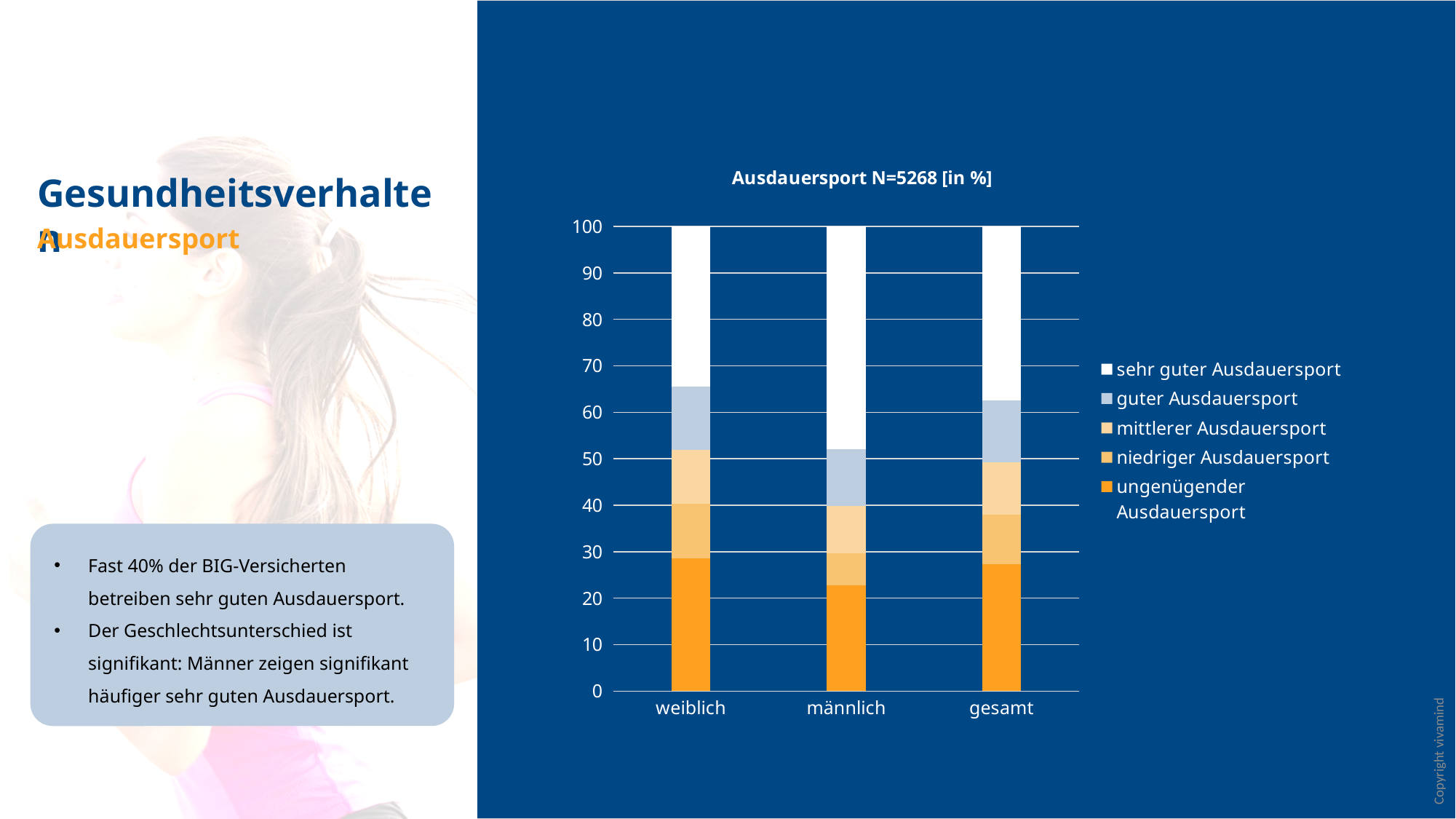
What is the title of the chart? Ausdauersport N=5268 [in %] Is the 'sehr guter Ausdauersport' value for 'weiblich' greater or less than 40? less Is the 'sehr guter Ausdauersport' value for 'männlich' greater or less than 40? greater How many categories are shown on the x axis of the chart? 3 Is the 'ungenügender Ausdauersport' value for 'weiblich' greater or less than 20? greater Which is larger, the 'ungenügender Ausdauersport' value for 'weiblich' or for 'männlich'? weiblich What is the total height of the stacked bar for 'weiblich'? 100 How many series does the chart legend list? 5 Which colour represents 'sehr guter Ausdauersport' in the chart? White Which category has the largest 'sehr guter Ausdauersport' segment? männlich What kind of chart is shown on the slide? Stacked bar chart